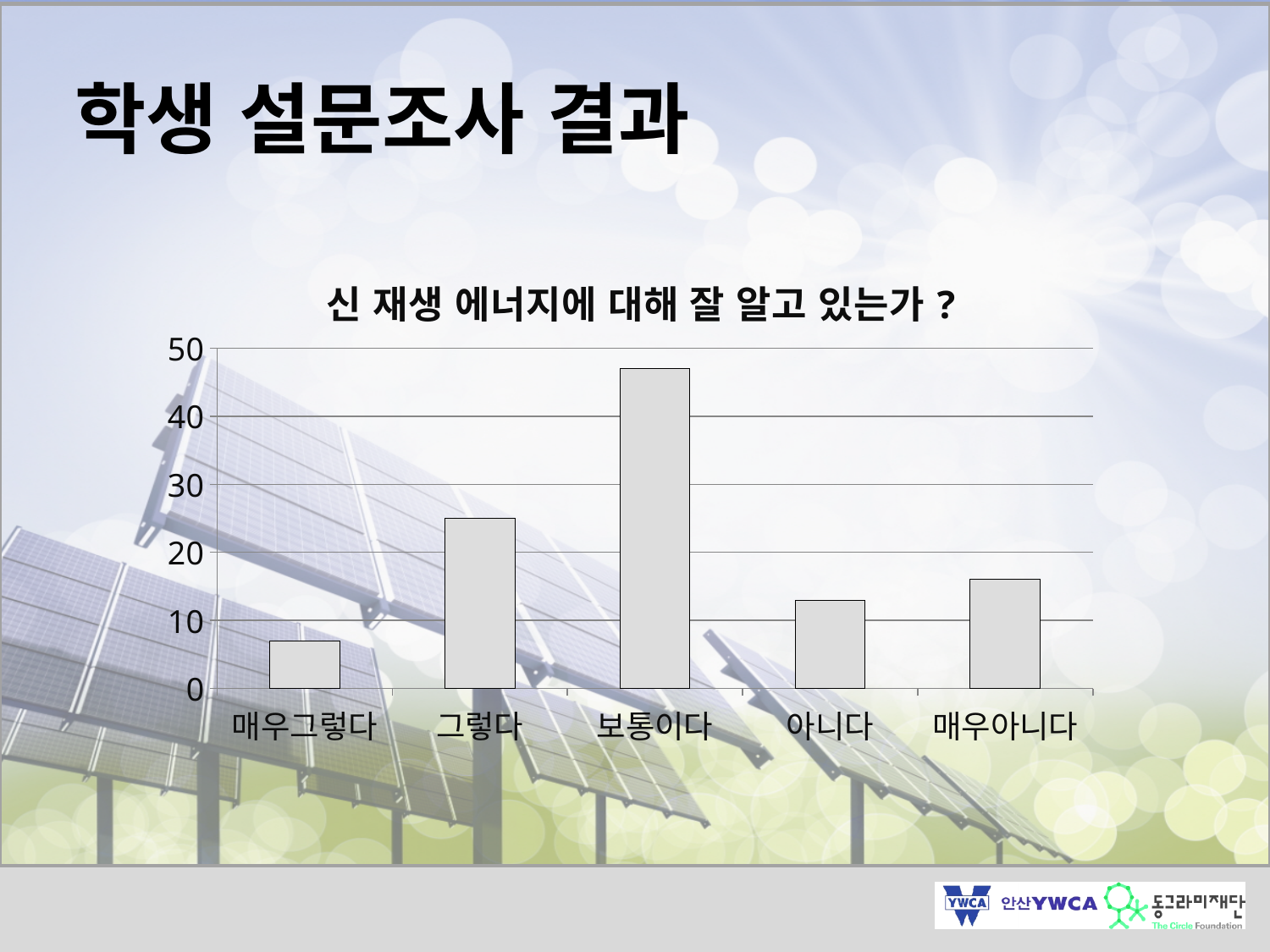
Which category has the highest bar? 보통이다 How many categories are shown on the x axis of the chart? 5 Is the value for 보통이다 greater or less than 40? greater Is the value for 그렇다 greater or less than 20? greater Is the value for 매우그렇다 greater or less than 10? less What is the title of the chart? 신 재생 에너지에 대해 잘 알고 있는가 ? What kind of chart is shown on the slide? bar chart Which is larger, the value for 그렇다 or the value for 매우아니다? 그렇다 Which category has the lowest bar? 매우그렇다 Which is larger, the value for 아니다 or the value for 매우아니다? 매우아니다 What is the maximum value shown on the y axis of the chart? 50